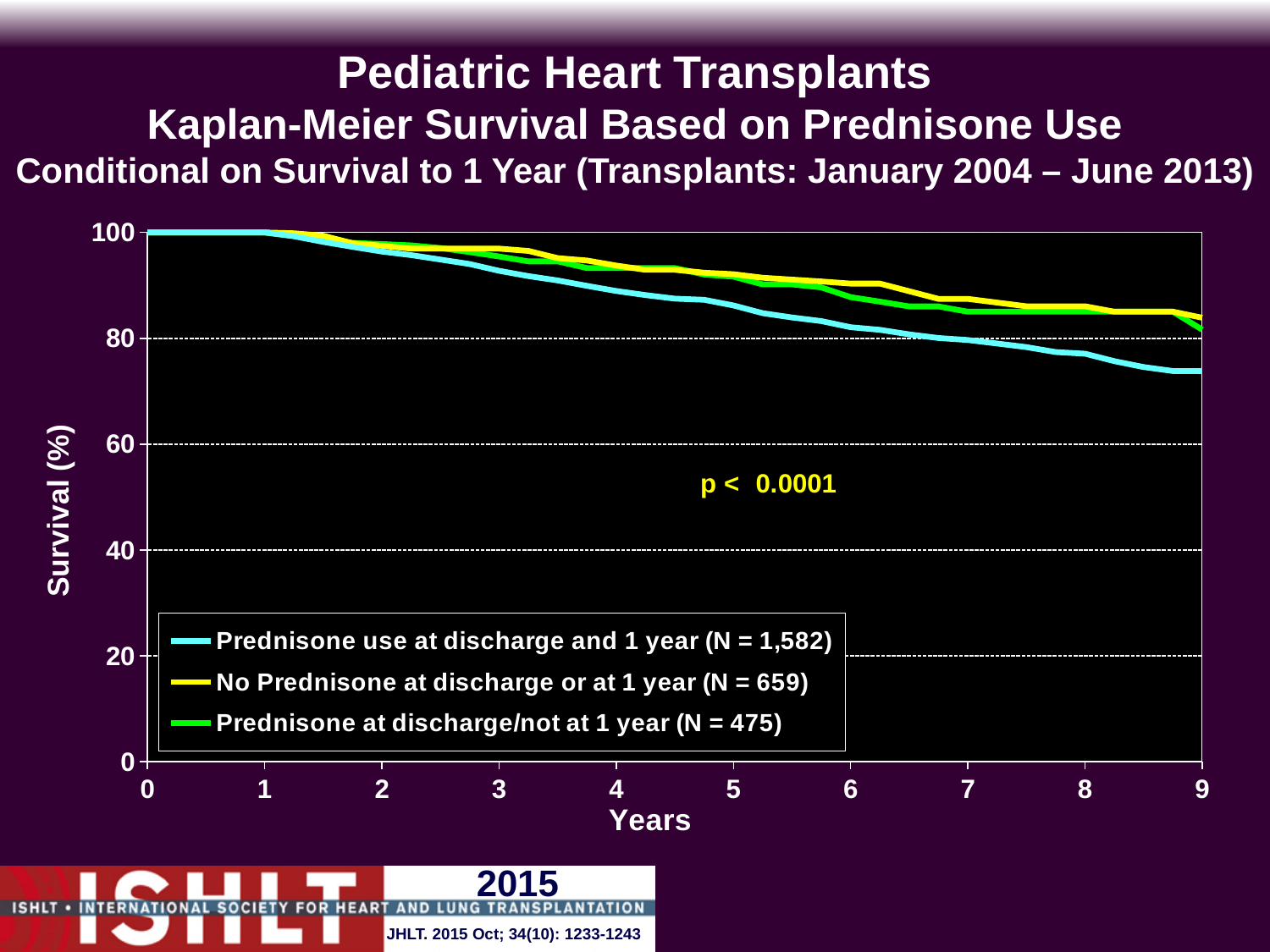
What is the N for the 'Prednisone use at discharge and 1 year' group shown in the legend? N = 1,582 At 9 years, which group has higher survival: 'Prednisone use at discharge and 1 year' or 'No Prednisone at discharge or at 1 year'? No Prednisone at discharge or at 1 year Is the survival value for the 'Prednisone at discharge/not at 1 year' group at 5 years greater or less than 80? greater Do the survival curves rise or fall as years since transplant increase? Fall Which group has the lowest survival at 8 years? Prednisone use at discharge and 1 year How many series does the legend list? 3 What kind of chart is shown on the slide? Line chart Is the survival value for the 'No Prednisone at discharge or at 1 year' group at 9 years greater or less than 80? greater Is the survival value for the 'Prednisone use at discharge and 1 year' group at 9 years greater or less than 80? less Which group has the highest survival at 9 years? No Prednisone at discharge or at 1 year What is the maximum value shown on the x axis (Years)? 9 What p-value is printed on the chart? p < 0.0001